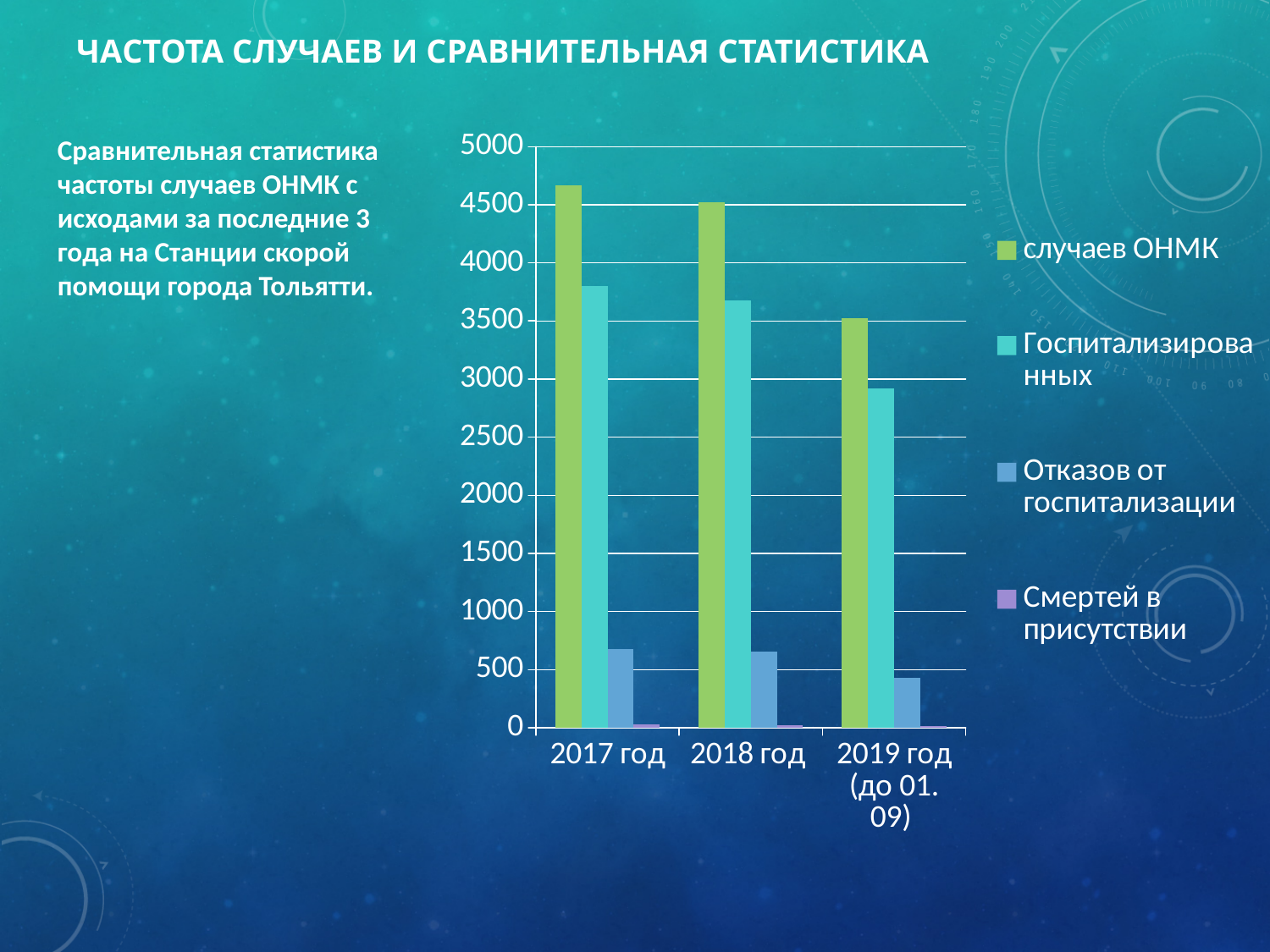
Do the values for случаев ОНМК rise or fall from 2017 год to 2019 год (до 01.09)? fall What kind of chart is shown on the slide? bar chart Which year has the highest value for случаев ОНМК? 2017 год How many year categories are shown on the x axis? 3 Is the value for Отказов от госпитализации in 2018 год greater or less than 1000? less Which is larger: Госпитализированных in 2017 год or Госпитализированных in 2019 год (до 01.09)? 2017 год Which series is shown in green in the legend? случаев ОНМК Is the value for случаев ОНМК in 2019 год (до 01.09) greater or less than 4000? less Which year has the lowest value for Госпитализированных? 2019 год (до 01.09) Is the value for Госпитализированных in 2019 год (до 01.09) greater or less than 3000? less How many series does the legend list? 4